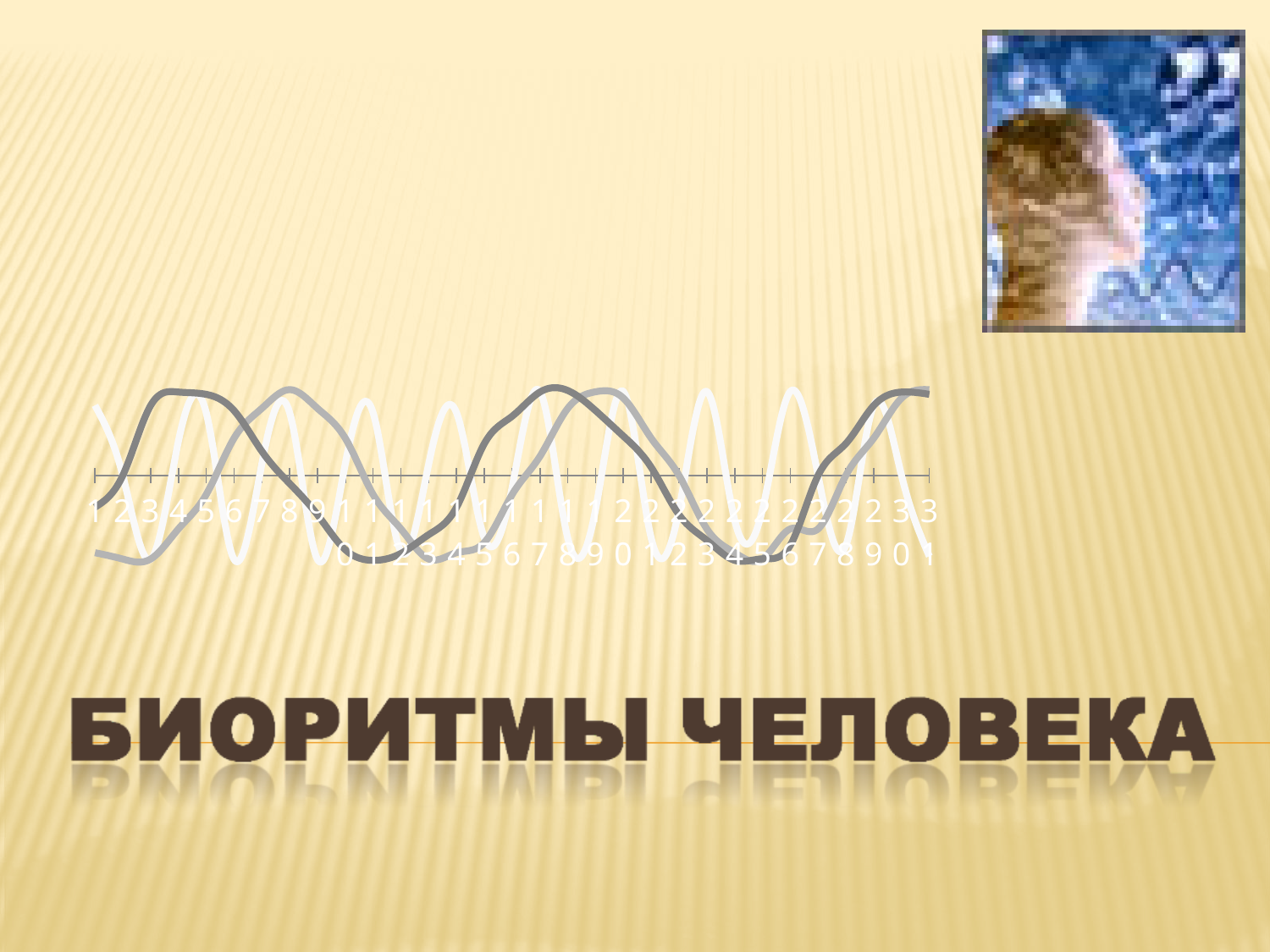
What kind of chart is shown on the slide? line chart Which line on the chart oscillates most frequently (has the shortest period)? the white line What colours are the three lines on the chart? white, light gray and dark gray How many lines (series) are plotted on the chart? 3 How many points are labelled along the x axis of the chart? 31 What is the last label on the x axis of the chart? 31 What is the first label on the x axis of the chart? 1